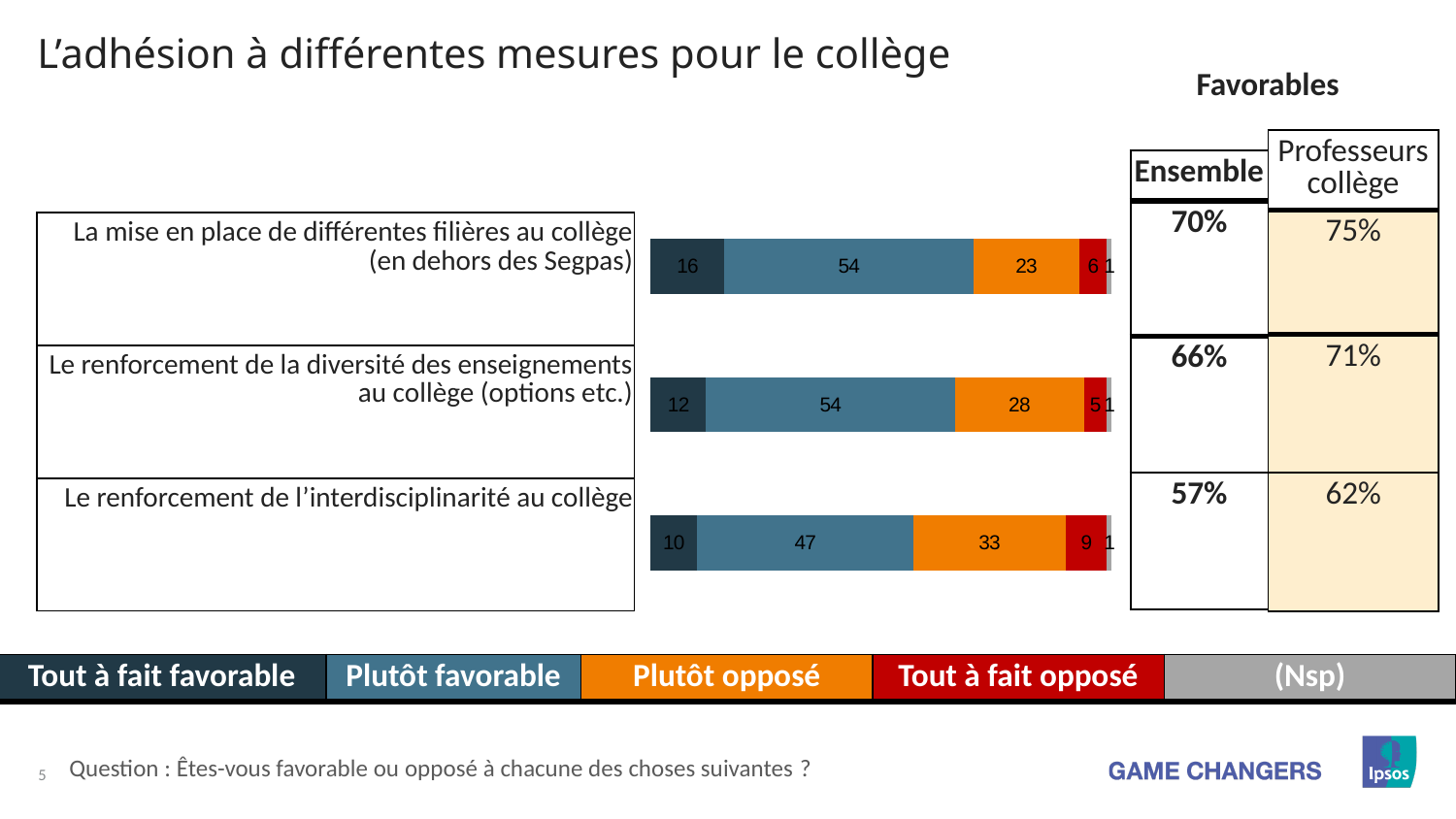
What kind of chart is shown on the slide? stacked bar chart Which measure has the lowest 'Plutôt favorable' value? Le renforcement de l'interdisciplinarité au collège Which measure has the highest 'Tout à fait favorable' value? La mise en place de différentes filières au collège (en dehors des Segpas) What colour represents the 'Plutôt opposé' series in the legend? orange How many series does the legend list? 5 What is the difference between the 'Plutôt opposé' values for 'Le renforcement de l'interdisciplinarité au collège' and 'La mise en place de différentes filières au collège (en dehors des Segpas)'? 10 How many measures (categories) are plotted in the chart? 3 Is the 'Tout à fait favorable' value larger for 'La mise en place de différentes filières au collège (en dehors des Segpas)' or for 'Le renforcement de la diversité des enseignements au collège (options etc.)'? La mise en place de différentes filières au collège (en dehors des Segpas) What is the 'Tout à fait opposé' value for 'Le renforcement de l'interdisciplinarité au collège'? 9 What is the 'Tout à fait favorable' value for 'Le renforcement de l'interdisciplinarité au collège'? 10 What is the 'Plutôt opposé' value for 'Le renforcement de la diversité des enseignements au collège (options etc.)'? 28 What is the 'Plutôt favorable' value for 'La mise en place de différentes filières au collège (en dehors des Segpas)'? 54